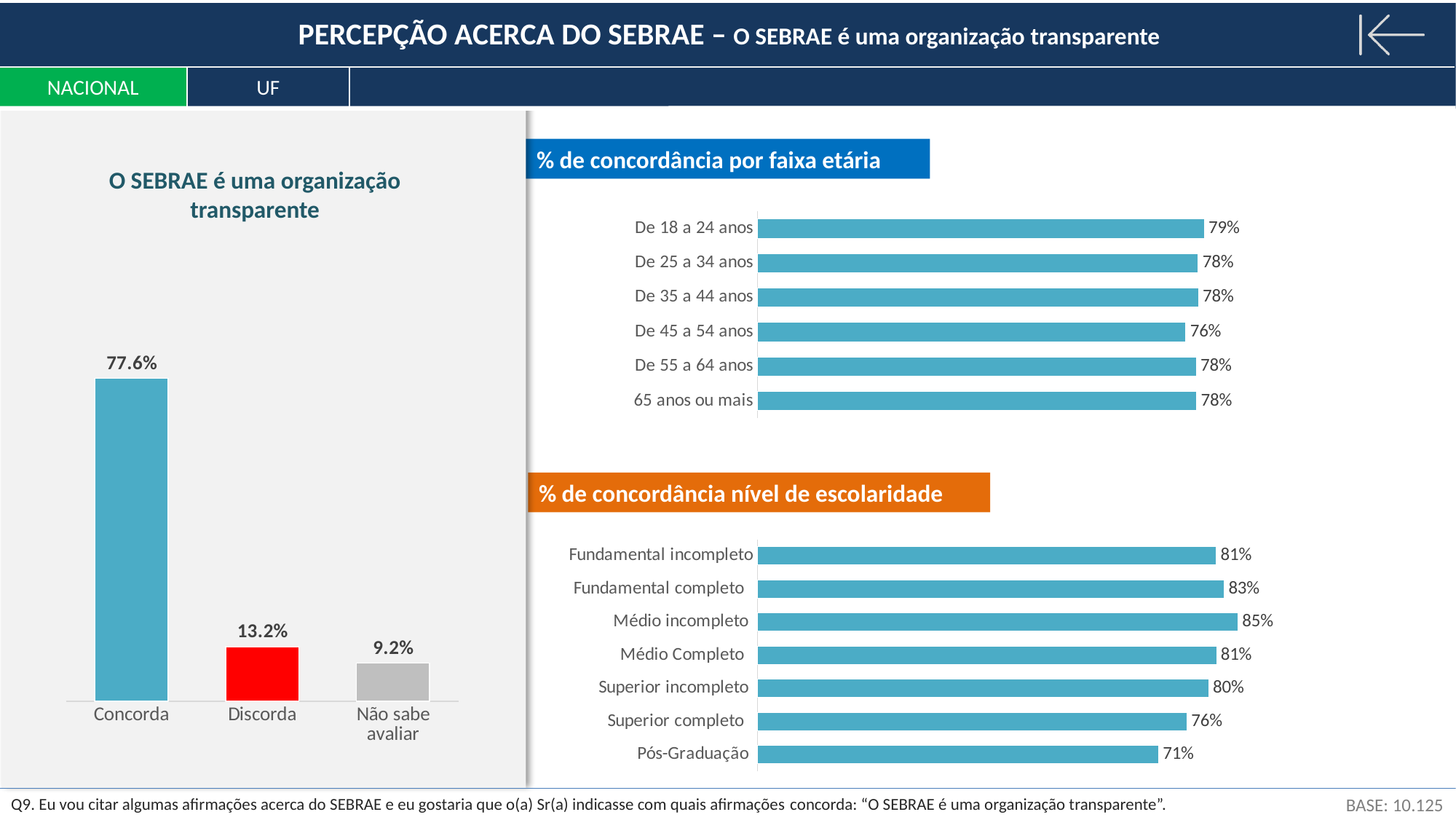
In the chart titled 'O SEBRAE é uma organização transparente', what is the difference between Concorda and Discorda? 64.4% In the chart '% de concordância nível de escolaridade', what is the difference between Fundamental completo and Superior completo? 7% In the chart titled 'O SEBRAE é uma organização transparente', what is the value for Não sabe avaliar? 9.2% In the chart titled 'O SEBRAE é uma organização transparente', what is the value for Concorda? 77.6% In the chart '% de concordância nível de escolaridade', which education level has the highest value? Médio incompleto In the chart '% de concordância por faixa etária', which age group has the highest value? De 18 a 24 anos In the chart titled 'O SEBRAE é uma organização transparente', how many categories are shown? 3 What kind of chart is '% de concordância nível de escolaridade'? Bar chart In the chart '% de concordância nível de escolaridade', what is the value for Pós-Graduação? 71% In the chart titled 'O SEBRAE é uma organização transparente', what colour is the Discorda bar? Red In the chart '% de concordância por faixa etária', what is the value for De 45 a 54 anos? 76% In the chart '% de concordância por faixa etária', how many age groups are shown? 6